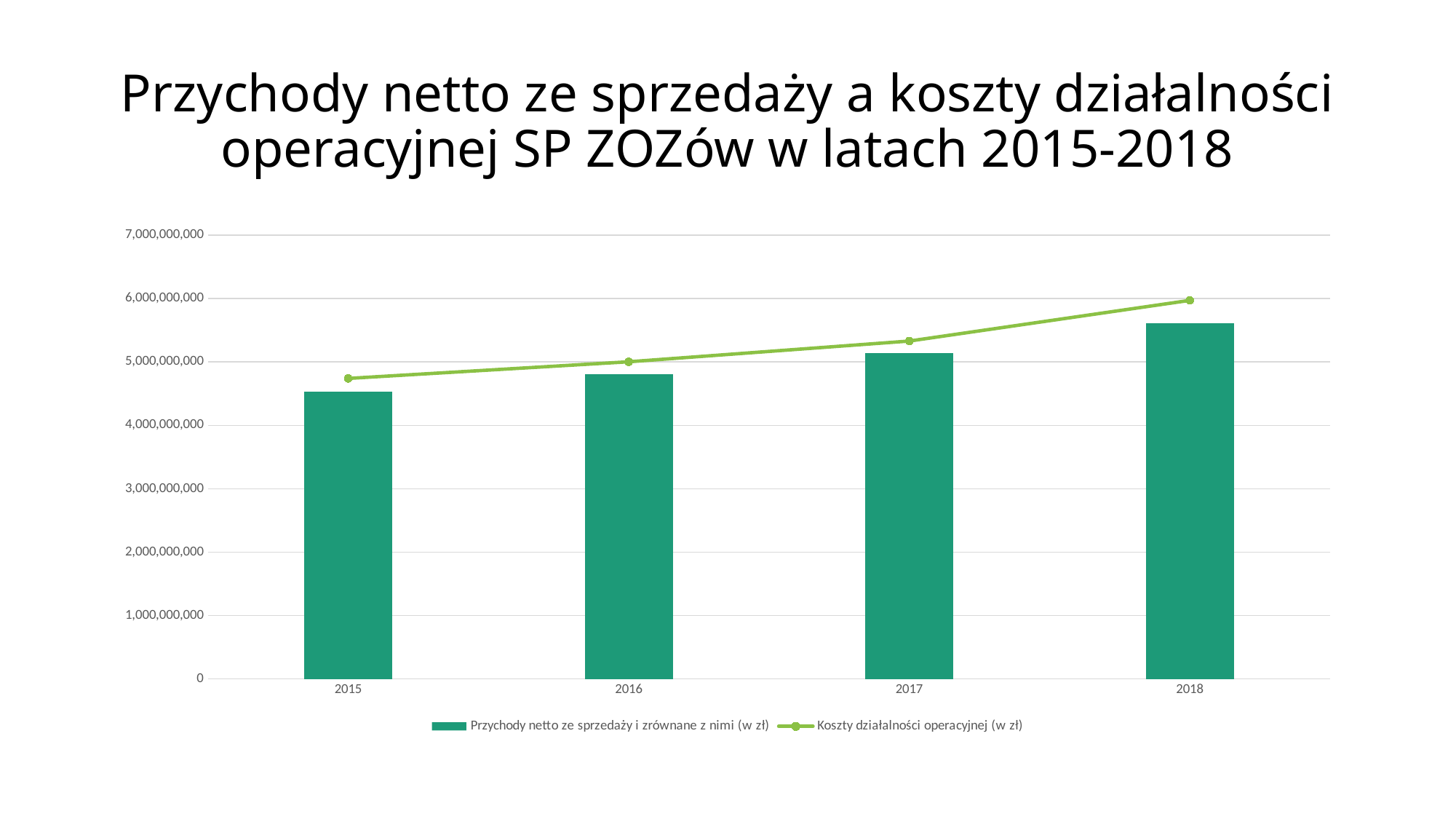
In 2018, which is larger: Przychody netto ze sprzedaży or Koszty działalności operacyjnej? Koszty działalności operacyjnej How many years are shown on the x axis of the chart? 4 Do the values of Koszty działalności operacyjnej rise or fall from 2015 to 2018? Rise Is the value of Koszty działalności operacyjnej in 2017 greater or less than 5,000,000,000? greater Is the bar value for Przychody netto ze sprzedaży in 2018 greater or less than 5,000,000,000? greater Is the bar value for Przychody netto ze sprzedaży in 2015 greater or less than 5,000,000,000? less What kind of chart is shown on the slide? A combination chart with bars and a line Which series is shown as a line in the chart? Koszty działalności operacyjnej (w zł) How many series does the chart legend list? 2 Which year has the lowest bar for Przychody netto ze sprzedaży i zrównane z nimi? 2015 Which year has the highest bar for Przychody netto ze sprzedaży i zrównane z nimi? 2018